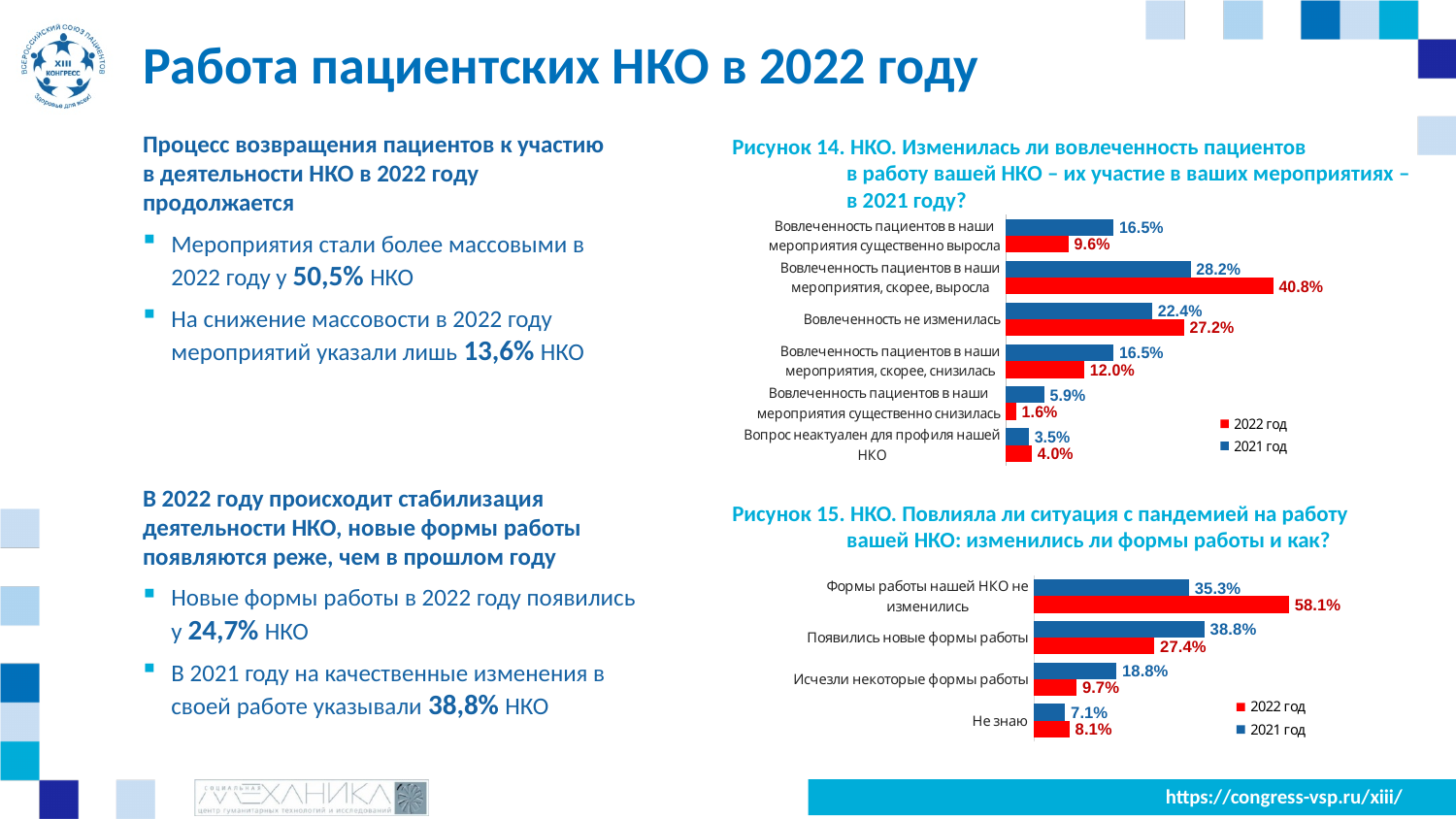
In the chart 'Рисунок 14', what is the difference between the 2022 год and 2021 год values for 'Вовлеченность пациентов в наши мероприятия, скорее, выросла'? 12.6% In the chart 'Рисунок 14', what is the 2022 год value for 'Вовлеченность пациентов в наши мероприятия, скорее, выросла'? 40.8% What type of chart is 'Рисунок 15'? Bar chart In the chart 'Рисунок 15', what is the difference between the 2021 год and 2022 год values for 'Исчезли некоторые формы работы'? 9.1% In the chart 'Рисунок 15', what is the 2022 год value for 'Формы работы нашей НКО не изменились'? 58.1% In the chart 'Рисунок 14', what is the 2021 год value for 'Вовлеченность не изменилась'? 22.4% In the chart 'Рисунок 15', which is larger for 'Появились новые формы работы': the 2021 год value or the 2022 год value? 2021 год In the chart 'Рисунок 15', which colour represents the 2022 год series? Red In the chart 'Рисунок 14', how many categories are shown? 6 In the chart 'Рисунок 14', which category has the highest 2022 год value? Вовлеченность пациентов в наши мероприятия, скорее, выросла In the chart 'Рисунок 14', which category has the lowest 2022 год value? Вовлеченность пациентов в наши мероприятия существенно снизилась In the chart 'Рисунок 14', how many series does the legend list? 2